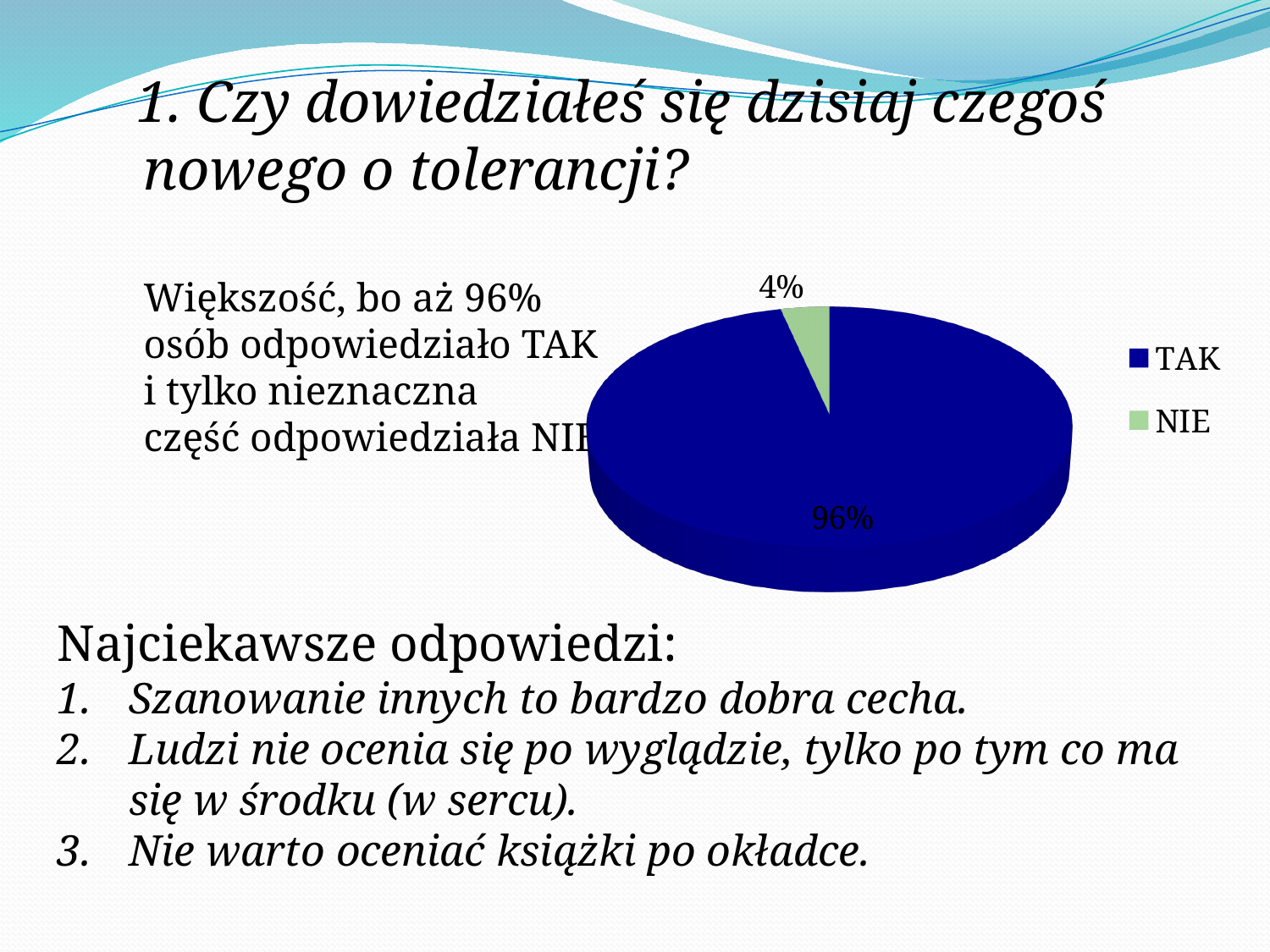
What share of the pie does NIE represent? 4% What colour is the TAK slice in the pie chart? dark blue Which slice of the pie is the smallest? NIE Which slice of the pie is the largest? TAK Which is larger, the TAK slice or the NIE slice? TAK What kind of chart is shown on the slide? pie chart What colour is the NIE slice in the pie chart? light green What is the difference in percentage points between the TAK and NIE slices? 92 How many entries does the legend list? 2 What share of the pie does TAK represent? 96% How many slices does the pie chart have? 2